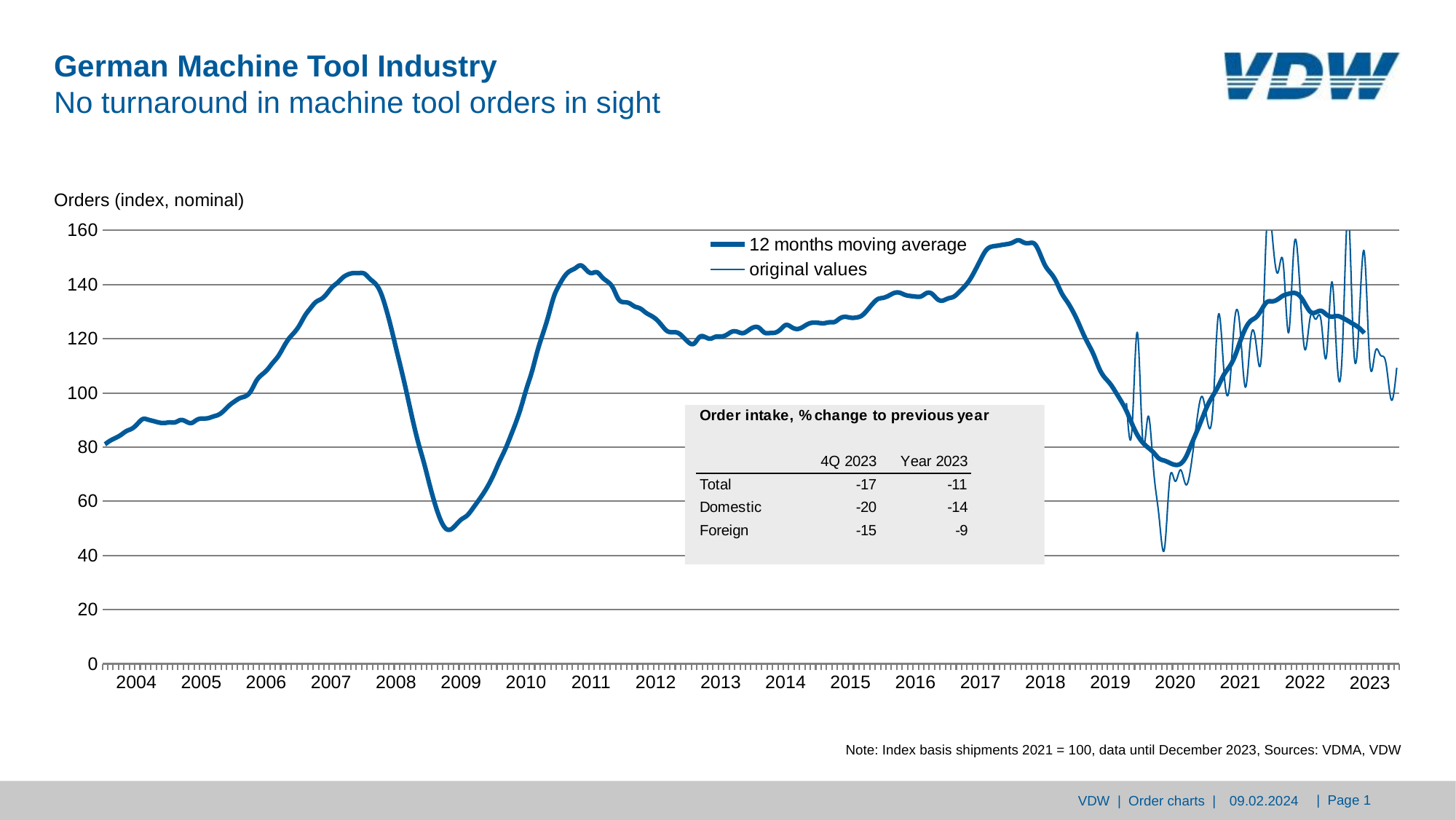
Is the lowest value of the 12 months moving average in 2020 greater or less than 80? less Does the 12 months moving average rise or fall between 2009 and 2011? rise What are the two series named in the chart legend? 12 months moving average; original values What kind of chart is shown on the slide? line chart How many series does the chart legend list? 2 What is the label shown above the y axis of the chart? Orders (index, nominal) Is the lowest value of the 12 months moving average in 2009 greater or less than 60? less Is the lowest point of the original values series in 2020 greater or less than 60? less Does the 12 months moving average rise or fall between 2018 and 2020? fall How many year labels are shown along the x axis of the chart? 20 Does the 12 months moving average rise or fall between 2008 and early 2009? fall